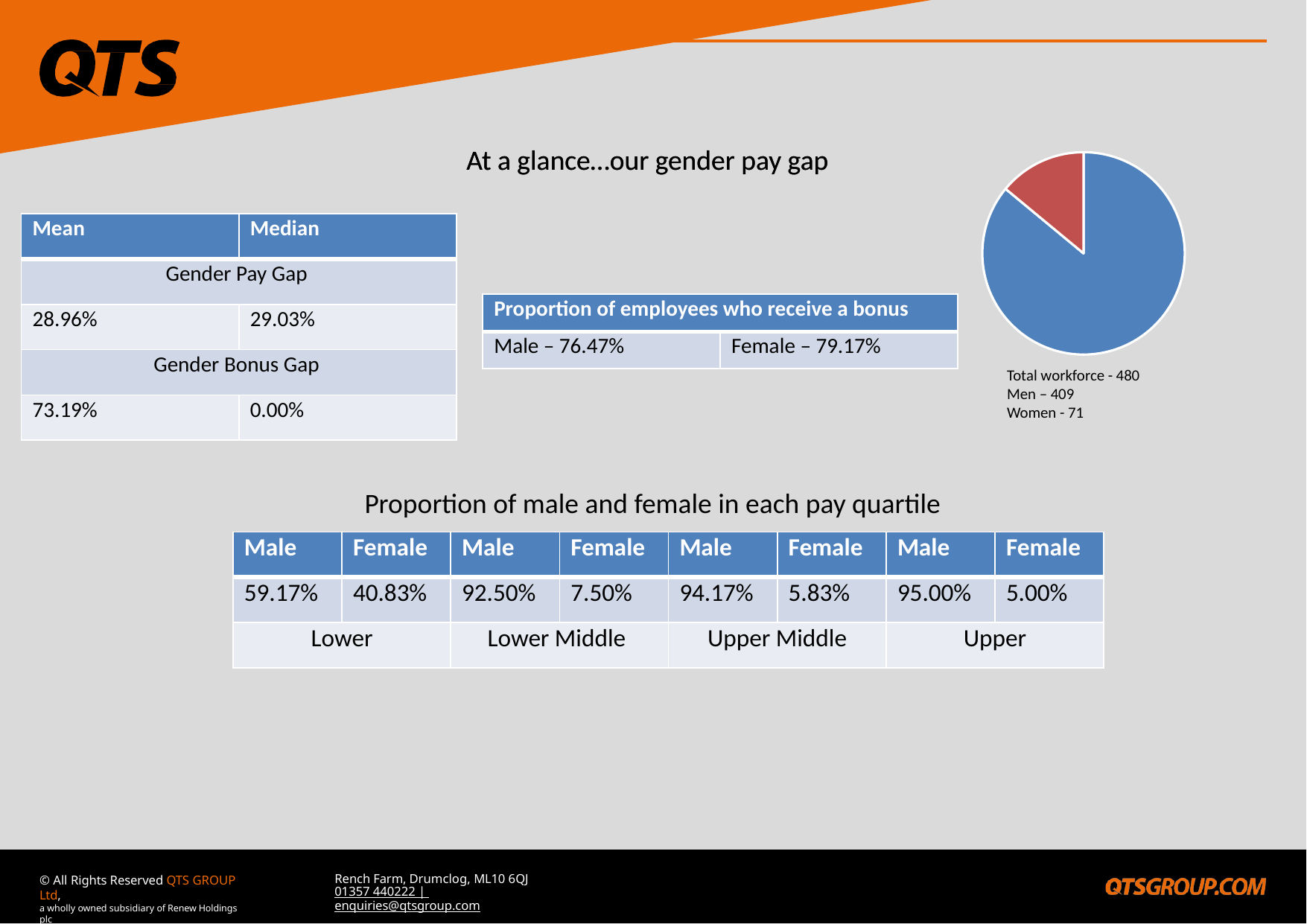
What kind of chart is shown at the top right of the slide? pie chart Which slice of the pie chart is the smallest? the red slice What two colours are used for the slices of the pie chart? blue and red Does the pie chart have a legend? No Which slice of the pie chart is larger, the blue one or the red one? blue What total workforce figure is printed beside the pie chart? 480 How many slices does the pie chart have? 2 According to the text beside the pie chart, how many men are in the workforce? 409 According to the text beside the pie chart, how many women are in the workforce? 71